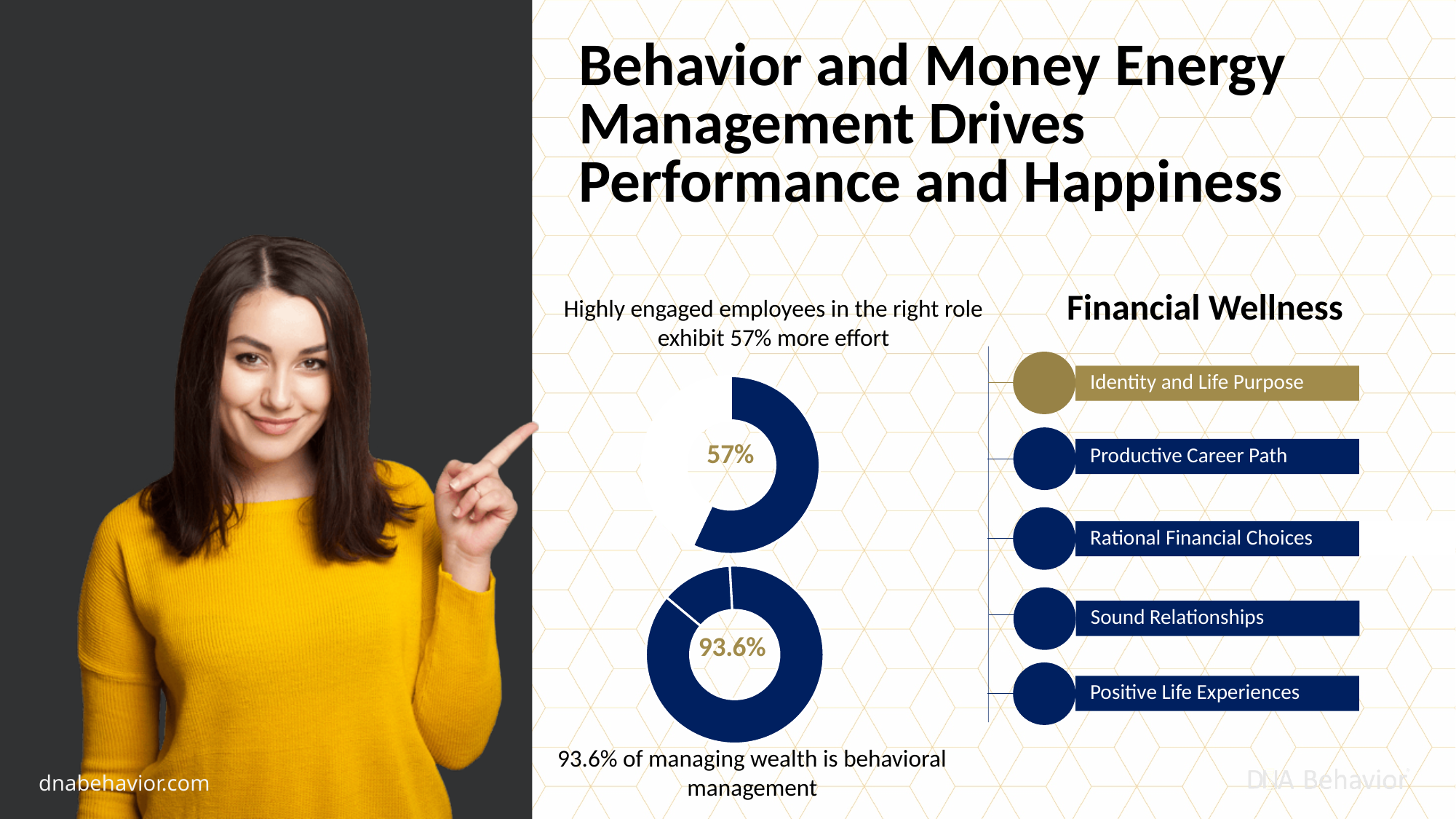
What percentage is printed in the centre of the upper donut chart? 57% How many donut charts are shown on the slide? 2 What percentage is printed in the centre of the lower donut chart? 93.6% Is the value shown in the upper donut chart greater or less than 50%? greater According to the caption below the lower donut chart, what does 93.6% of managing wealth consist of? Behavioral management Is the value shown in the lower donut chart greater or less than 90%? greater According to the caption above the upper donut chart, what do highly engaged employees in the right role exhibit? 57% more effort Which of the two donut charts shows the larger percentage, the upper one or the lower one? The lower one (93.6%) What kind of chart is the upper chart on the slide, labelled 57%? Donut (pie) chart What is the difference between the percentage in the lower donut chart and the percentage in the upper donut chart? 36.6 percentage points